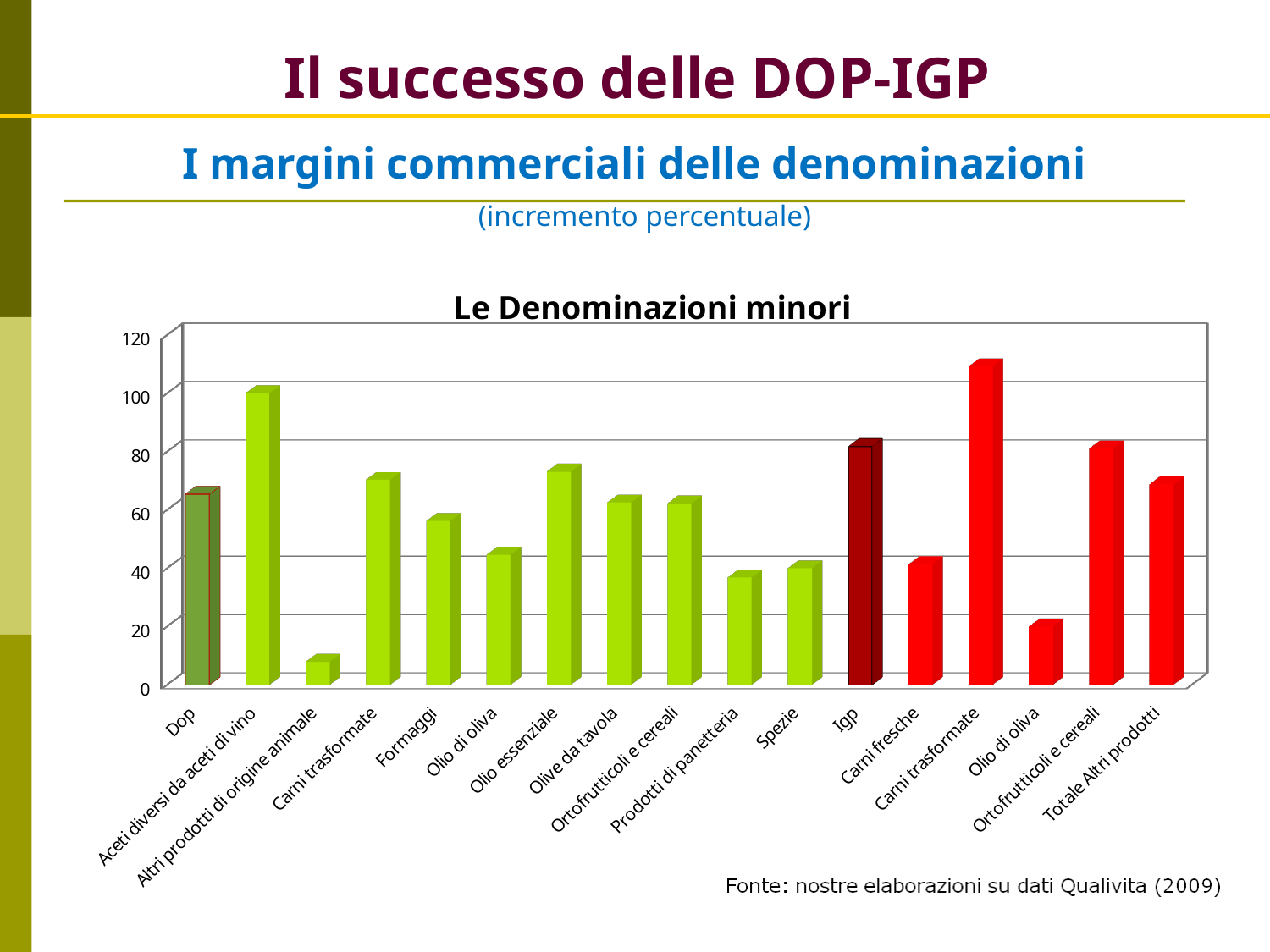
Is the value for Prodotti di panetteria greater or less than 40? less What kind of chart is shown on the slide? bar chart Is the value for Dop greater or less than 60? greater Is the value for the red Carni trasformate bar greater or less than 100? greater How many categories are shown along the x axis of the chart? 17 Which category has the lowest bar in the chart? Altri prodotti di origine animale Which is larger, the value for Carni fresche or the value for Totale Altri prodotti? Totale Altri prodotti Which category has the highest bar in the chart? Carni trasformate (red, Igp group) What is the source cited below the chart? Fonte: nostre elaborazioni su dati Qualivita (2009) Which is larger, the value for Aceti diversi da aceti di vino or the value for Olio essenziale? Aceti diversi da aceti di vino What is the title of the chart? Le Denominazioni minori